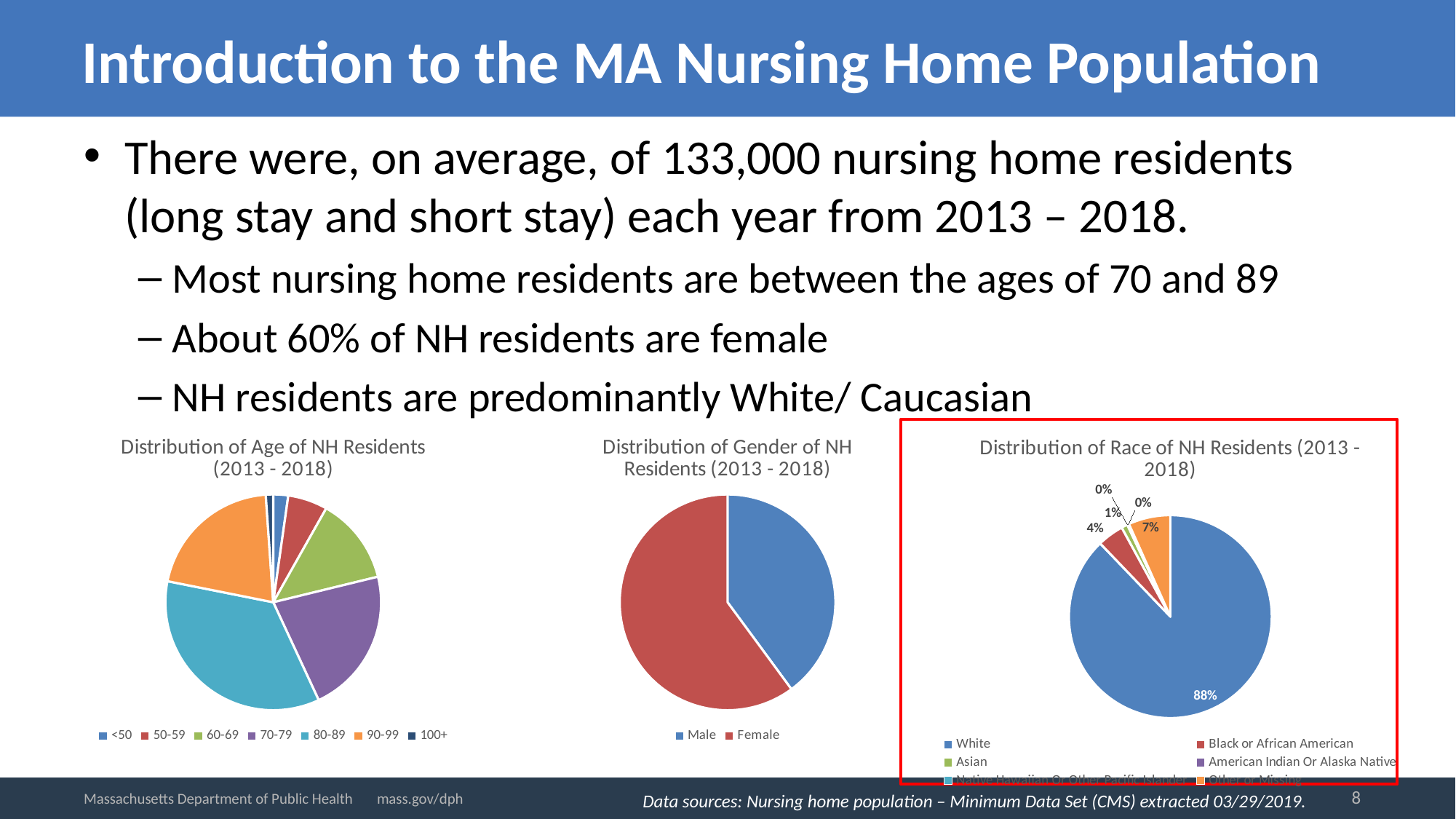
In the 'Distribution of Age of NH Residents (2013 - 2018)' chart, which age group has the largest slice? 80-89 In the 'Distribution of Race of NH Residents (2013 - 2018)' chart, what percentage is shown for Black or African American? 4% How many age groups does the legend of the 'Distribution of Age of NH Residents (2013 - 2018)' chart list? 7 How many categories does the legend of the 'Distribution of Race of NH Residents (2013 - 2018)' chart list? 6 In the 'Distribution of Race of NH Residents (2013 - 2018)' chart, what is the difference in percentage points between White and Other or Missing? 81 In the 'Distribution of Race of NH Residents (2013 - 2018)' chart, what percentage is shown for White? 88% In the 'Distribution of Race of NH Residents (2013 - 2018)' chart, which category has the largest share? White What type of chart is the 'Distribution of Gender of NH Residents (2013 - 2018)' chart? Pie chart In the 'Distribution of Race of NH Residents (2013 - 2018)' chart, which is larger, Black or African American or Other or Missing? Other or Missing In the 'Distribution of Race of NH Residents (2013 - 2018)' chart, what percentage is shown for Other or Missing? 7% In the 'Distribution of Race of NH Residents (2013 - 2018)' chart, what percentage is shown for Asian? 1% In the 'Distribution of Gender of NH Residents (2013 - 2018)' chart, which slice is larger, Male or Female? Female